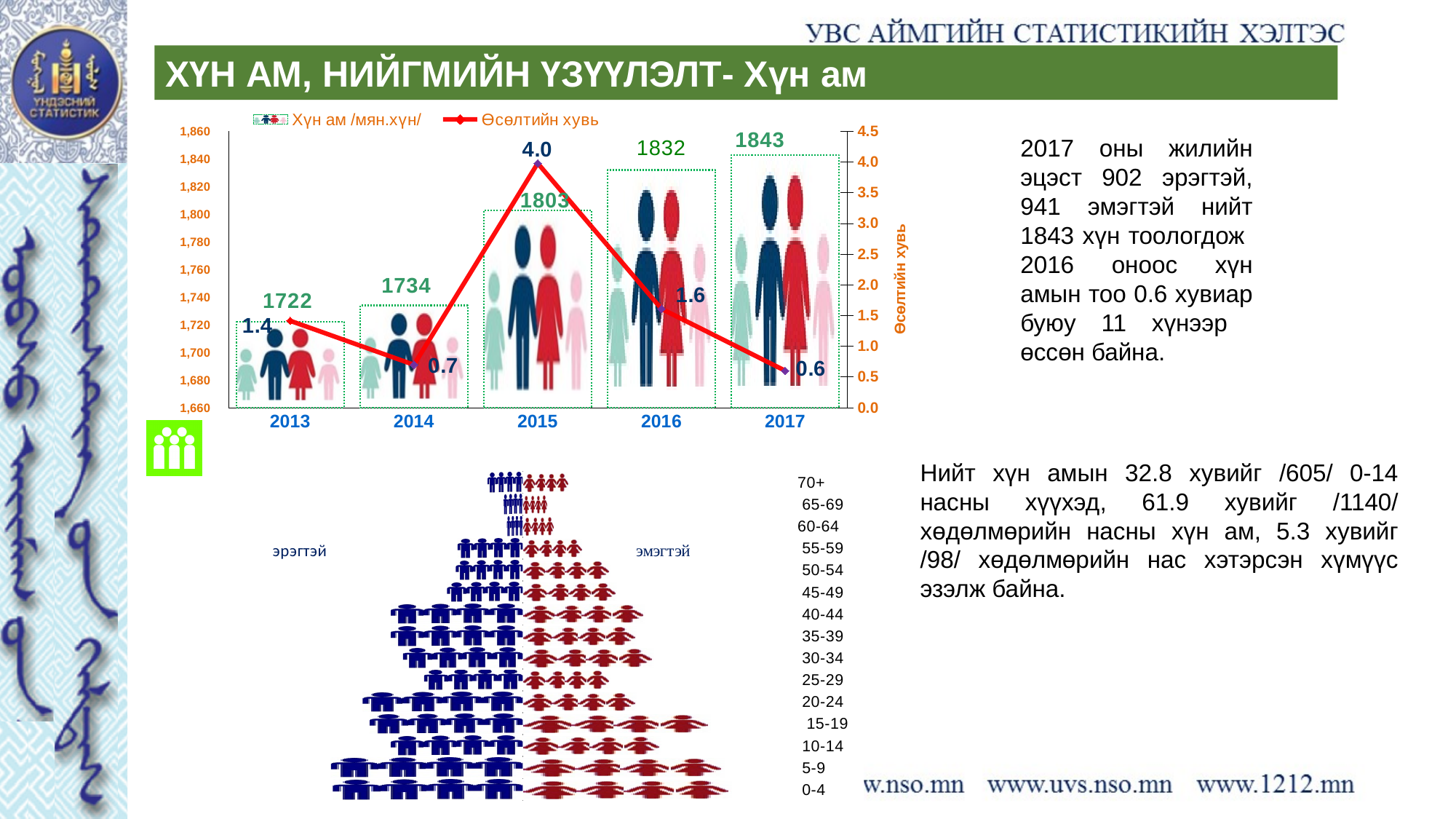
In the top chart, what is the growth rate (Өсөлтийн хувь) for 2014? 0.7 In the top chart, how many years are shown on the x axis? 5 How many series does the legend of the top chart list? 2 In the top chart, which year has the lowest population (Хүн ам) value? 2013 In the top chart, what is the population (Хүн ам) value for 2015? 1803 In the bottom chart, which age group is at the top of the pyramid? 70+ In the top chart, which is larger: the growth rate for 2013 or for 2016? 2016 In the top chart, which year has the highest growth rate (Өсөлтийн хувь)? 2015 In the top chart, what is the difference between the growth rates for 2015 and 2014? 3.3 In the top chart, what is the growth rate (Өсөлтийн хувь) for 2017? 0.6 In the top chart, does the population (Хүн ам) rise or fall from 2013 to 2017? rise In the top chart, what is the difference between the population values for 2017 and 2016? 11